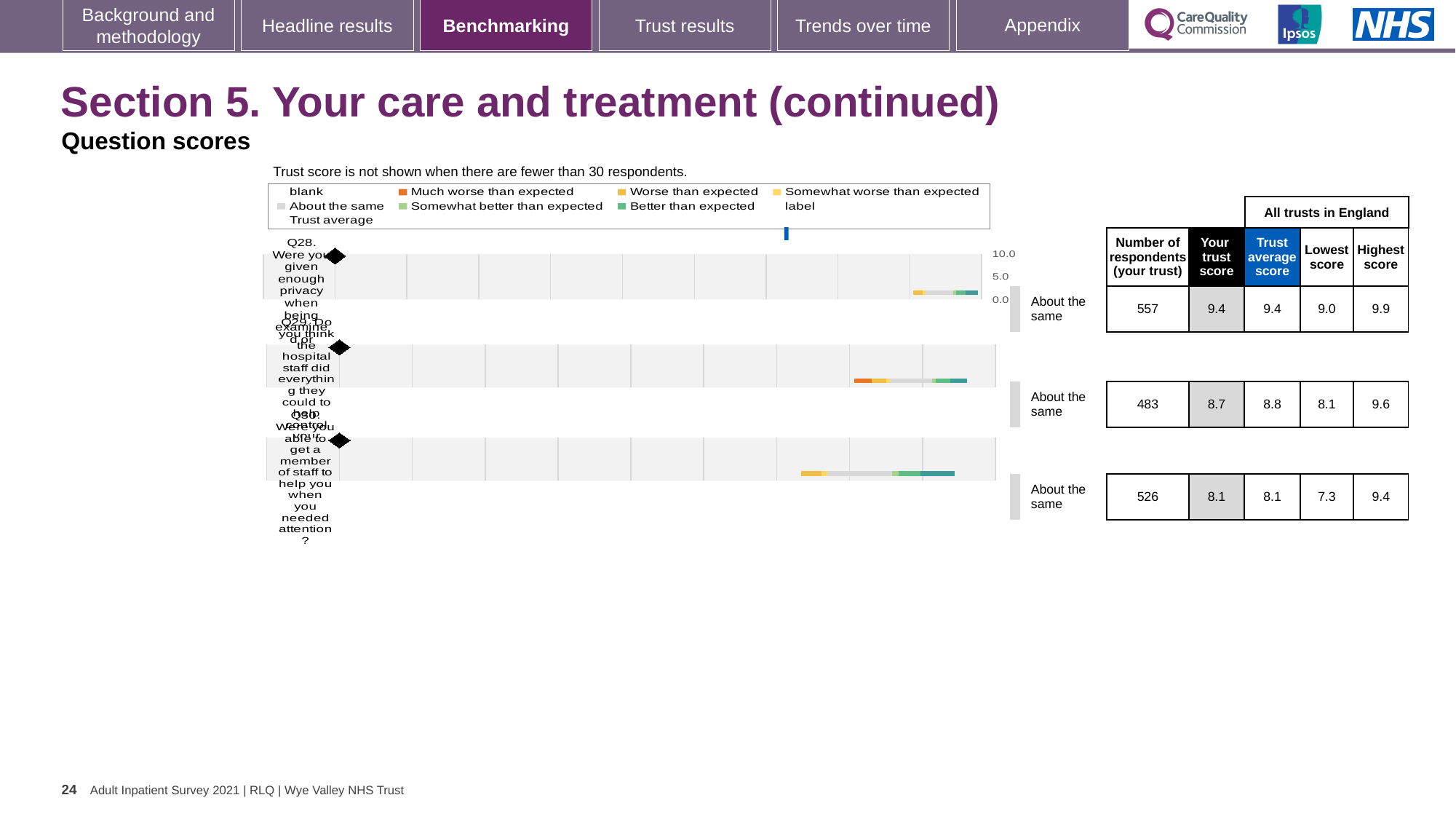
Which of the three questions shown has the lowest trust score? Q30 Which of the three questions shown has the most respondents? Q28 Is the trust score for Q30 greater or less than 5.0 on the chart axis? greater How many questions are plotted on this slide? 3 What is the difference between the highest score and the lowest score for Q30? 2.1 What is the lowest score across all trusts in England for Q29? 8.1 What benchmark category is shown for Q29? About the same How many respondents answered Q29 for this trust? 483 What is the trust score for Q28 (Were you given enough privacy when being examined or treated)? 9.4 Is the trust score for Q28 higher or lower than the trust score for Q29? higher What is the highest score across all trusts in England for Q30? 9.4 According to the note above the charts, when is the trust score not shown? When there are fewer than 30 respondents